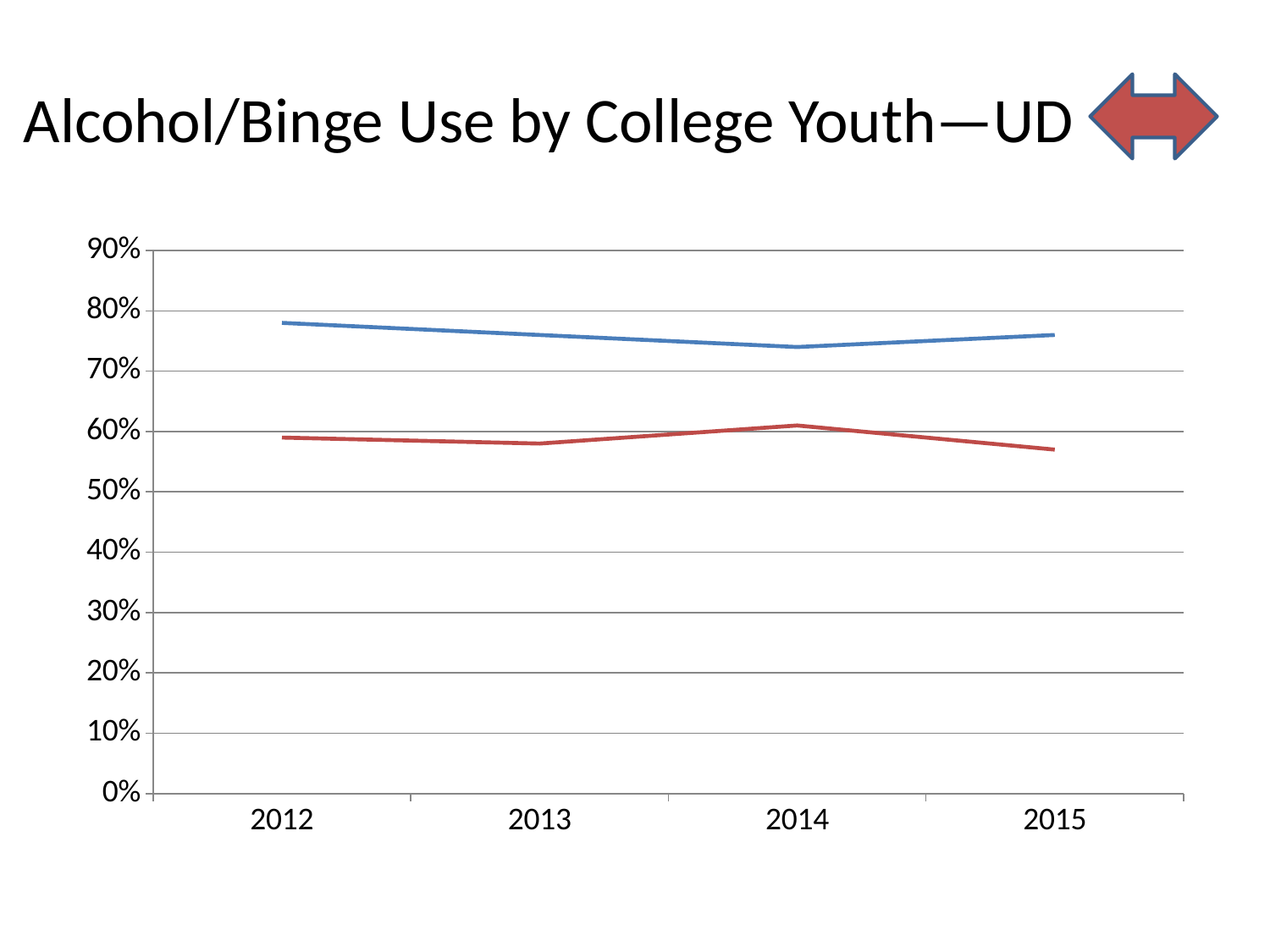
Is the value of the blue line in 2012 greater or less than 70%? greater What kind of chart is shown on the slide? line chart Does the blue line rise or fall from 2012 to 2014? fall Is the value of the blue line in 2014 greater or less than 80%? less In which year does the blue line reach its lowest value? 2014 How many lines are plotted on the chart? 2 In 2014, which line has the higher value, the blue line or the red line? the blue line Is the value of the red line in 2015 greater or less than 70%? less What is the title of the chart on the slide? Alcohol/Binge Use by College Youth—UD How many years are shown on the x axis of the chart? 4 In which year does the blue line reach its highest value? 2012